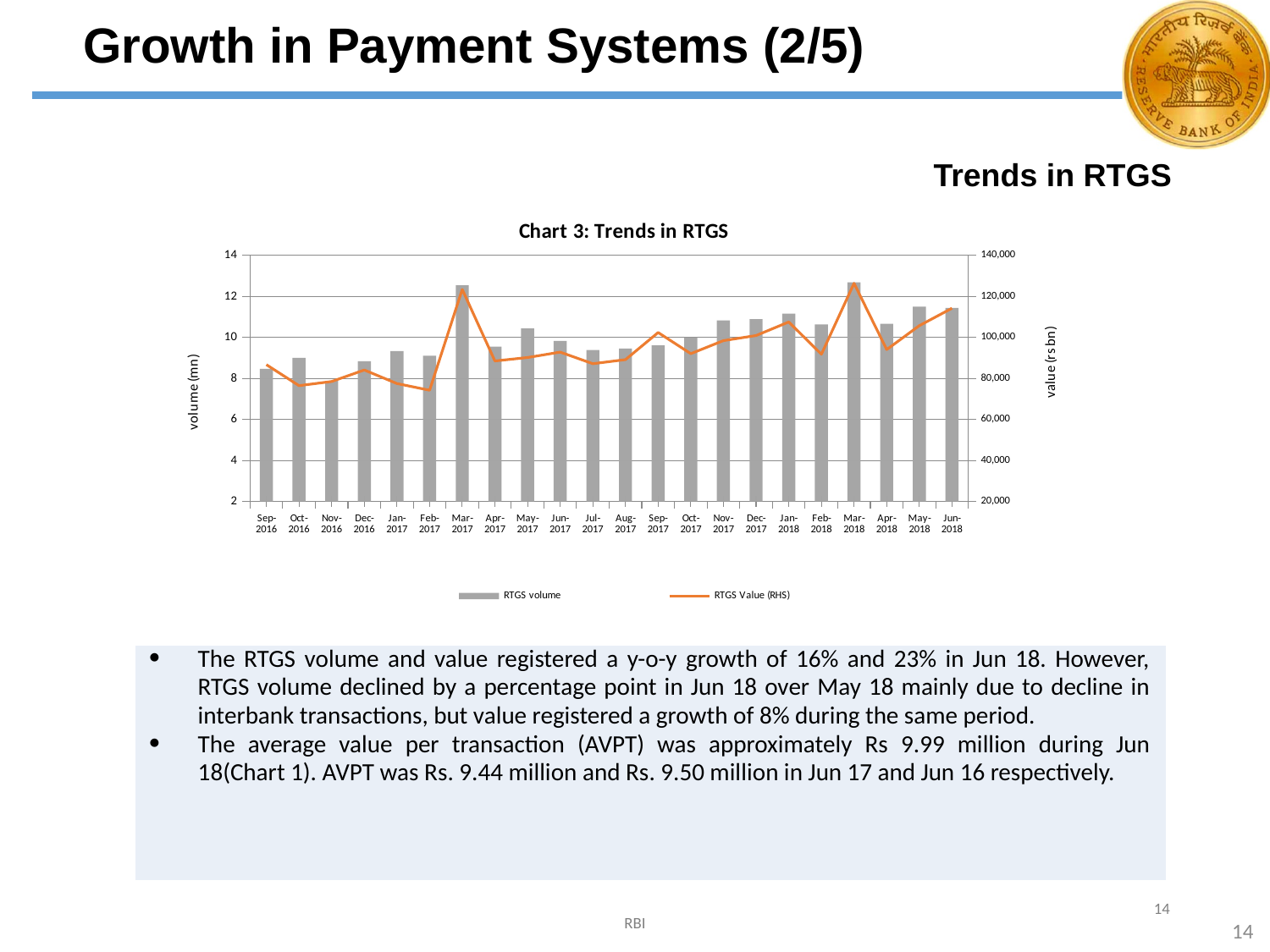
In Chart 3, is the RTGS Value for Mar-2018 greater or less than 120,000? greater What are the two series named in the legend of Chart 3? RTGS volume and RTGS Value (RHS) In Chart 3, does the RTGS volume generally rise or fall from Sep-2016 to Jun-2018? rise How many series does the legend of Chart 3 list? 2 What is the title of the chart on the slide? Chart 3: Trends in RTGS In Chart 3, is the RTGS volume for Mar-2017 greater or less than 12? greater In Chart 3, is the RTGS Value for Feb-2017 greater or less than 80,000? less How many months are plotted along the x axis of Chart 3? 22 In Chart 3, which month has the larger RTGS volume, Jun-2017 or Jun-2018? Jun-2018 What kind of chart is Chart 3: Trends in RTGS? A combination bar and line chart